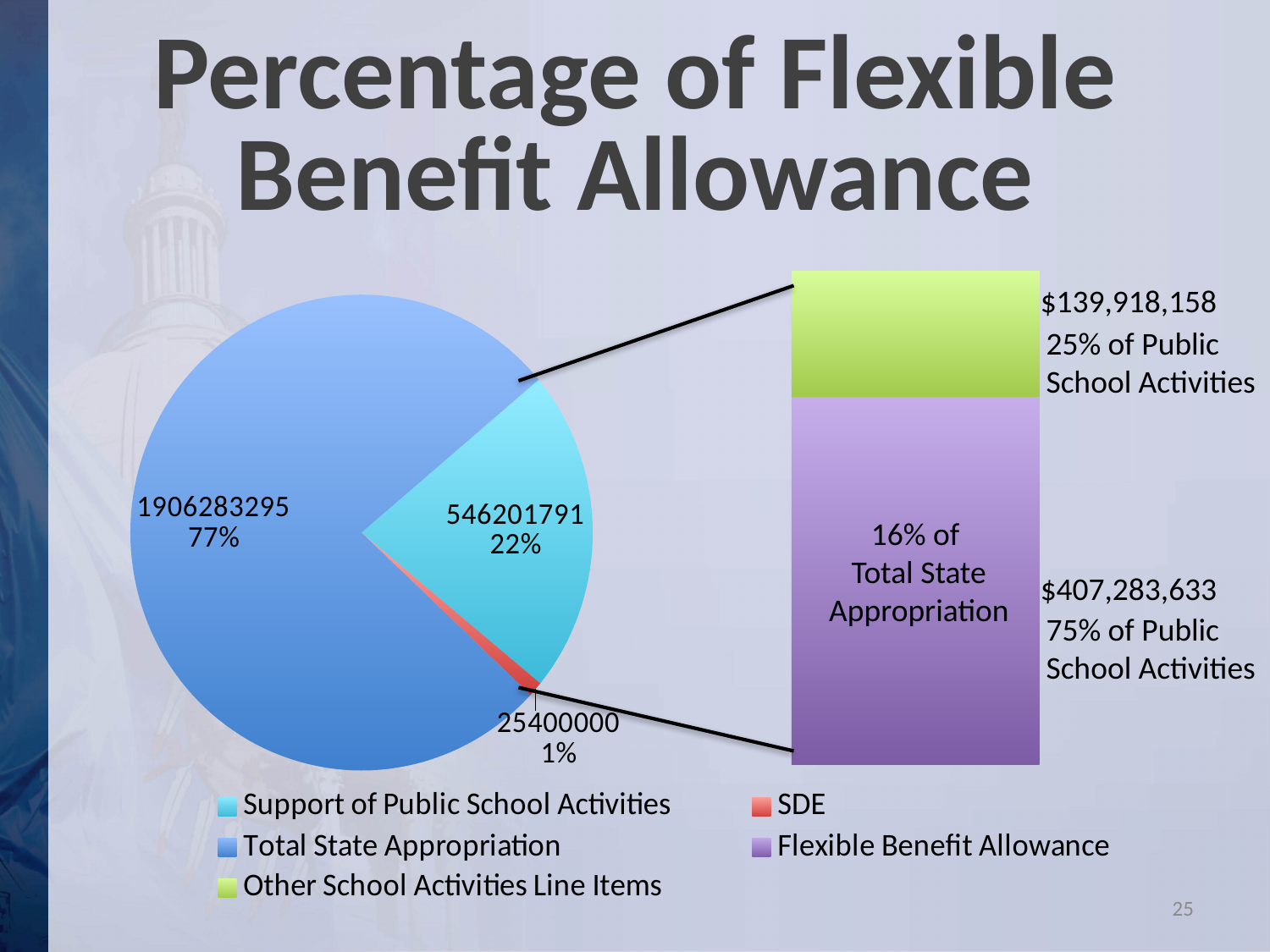
What percentage of the pie does the Support of Public School Activities slice represent? 22% How many entries does the legend list? 5 What kind of chart is shown on the left of the slide? Pie chart What value is shown for the Total State Appropriation slice of the pie chart? 1906283295 Which slice of the pie chart is the smallest? SDE What percentage of the pie does the Total State Appropriation slice represent? 77% Which slice of the pie chart is the largest? Total State Appropriation What value is shown for the SDE slice of the pie chart? 25400000 What percentage of Public School Activities does the Flexible Benefit Allowance represent? 75% Which is larger, the Support of Public School Activities slice or the SDE slice? Support of Public School Activities What dollar amount is shown for the Flexible Benefit Allowance segment of the stacked bar? $407,283,633 What dollar amount is shown for the Other School Activities Line Items segment of the stacked bar? $139,918,158